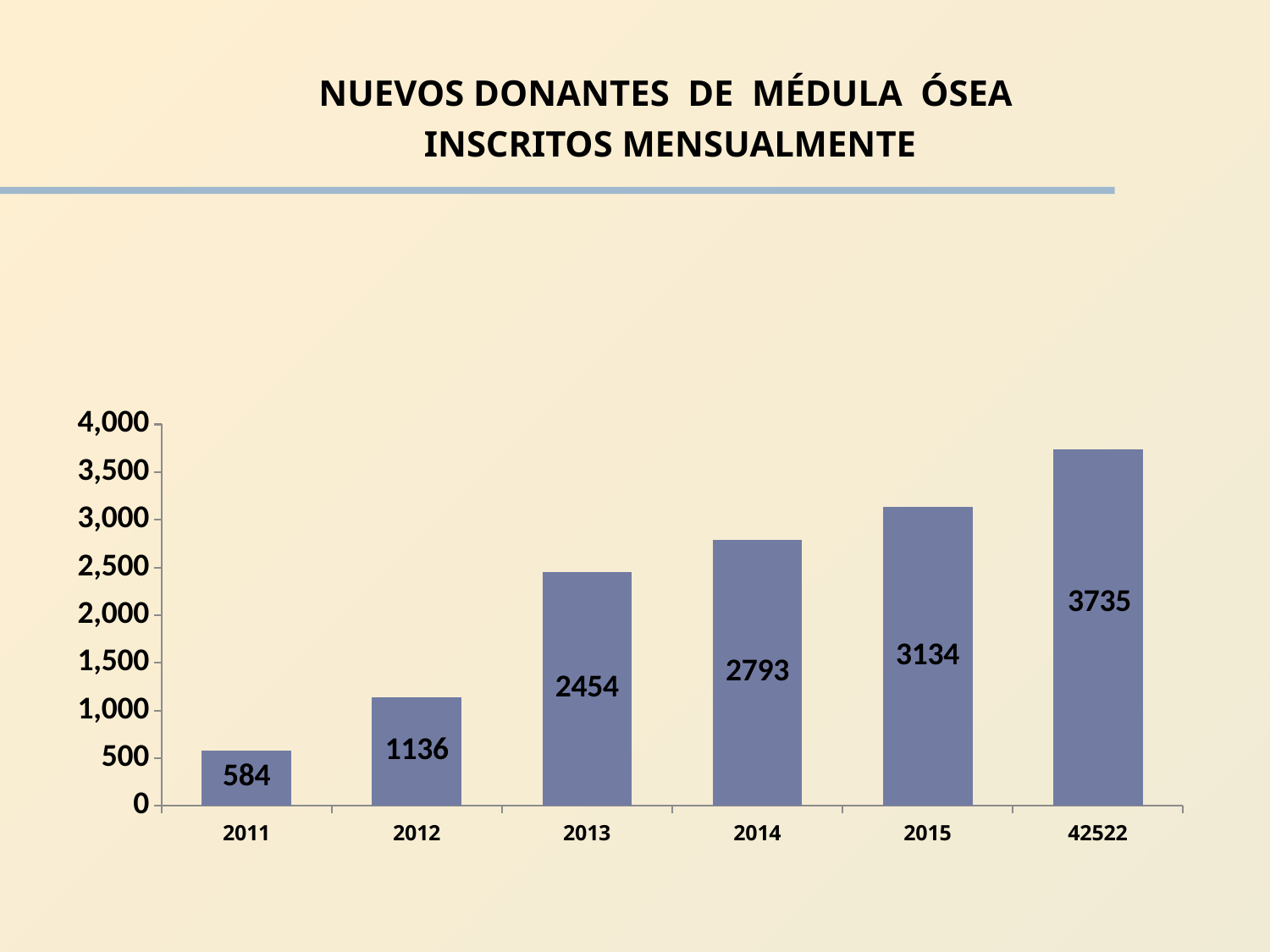
What is the value for 2015? 3134 What kind of chart is shown on the slide? bar chart Which category has the highest value? 42522 What is the value for 2013? 2454 Do the values rise or fall from left to right along the x axis? rise What is the value for 2011? 584 How many categories are shown on the x axis? 6 What is the difference between the values for 2012 and 2011? 552 What is the difference between the values for 2014 and 2013? 339 Which is larger, the value for 2014 or the value for 2015? 2015 Which category has the lowest value? 2011 What is the value for the category labelled 42522? 3735